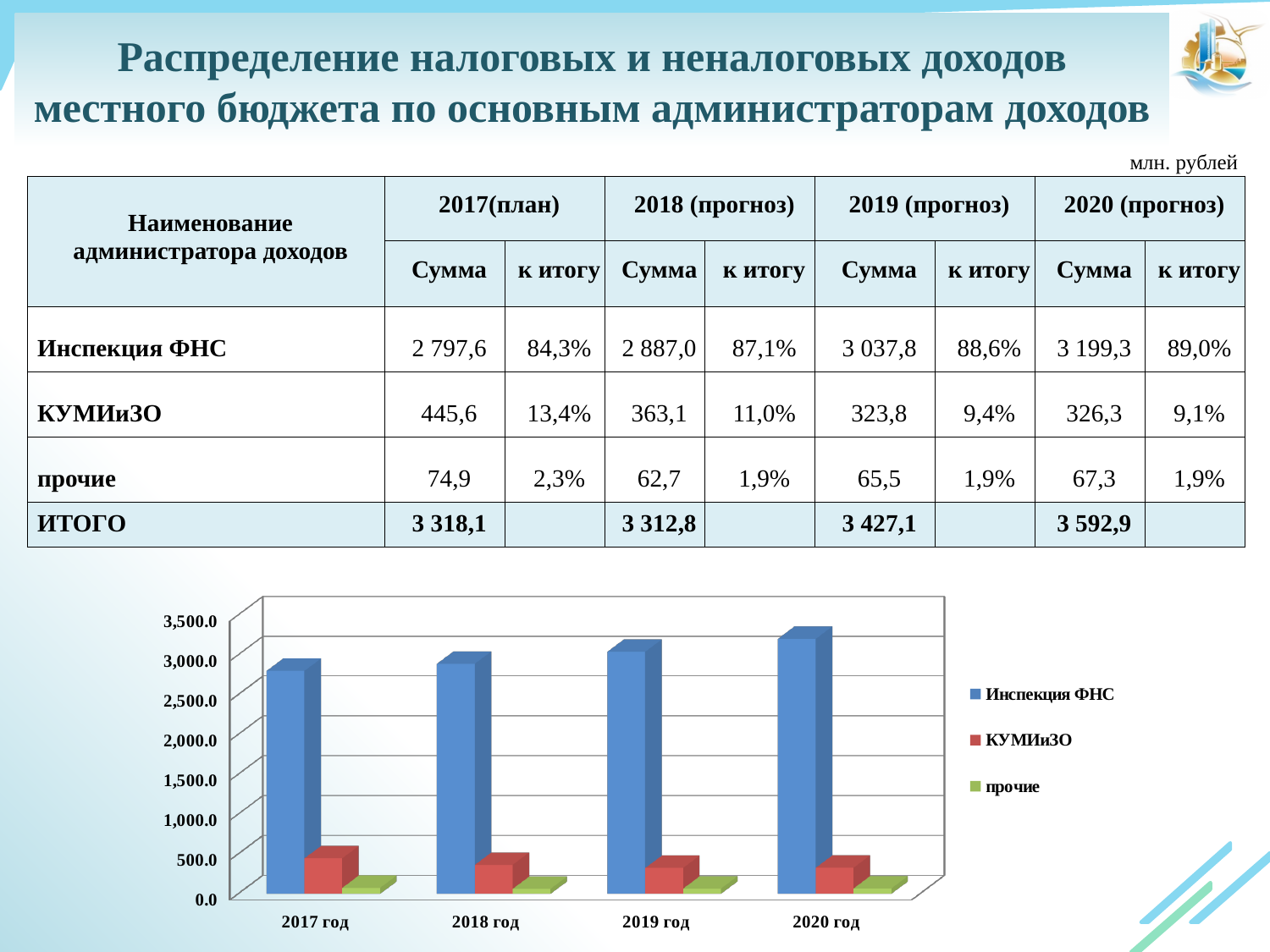
Is the bar for КУМИиЗО in 2017 год greater or less than 1,000.0? less Which series has the shortest bars in the chart? прочие In 2019 год, which bar is larger: Инспекция ФНС or КУМИиЗО? Инспекция ФНС In which year is the bar for Инспекция ФНС the highest? 2020 год Is the bar for прочие in 2019 год greater or less than 500.0? less Is the bar for Инспекция ФНС in 2020 год greater or less than 3,000.0? greater How many year categories are shown on the x axis of the chart? 4 How many series does the chart legend list? 3 Which series has the tallest bars in the chart? Инспекция ФНС What kind of chart is shown at the bottom of the slide? bar chart What colour does the legend use for the КУМИиЗО series? red Do the bars for Инспекция ФНС rise or fall from 2017 год to 2020 год? rise